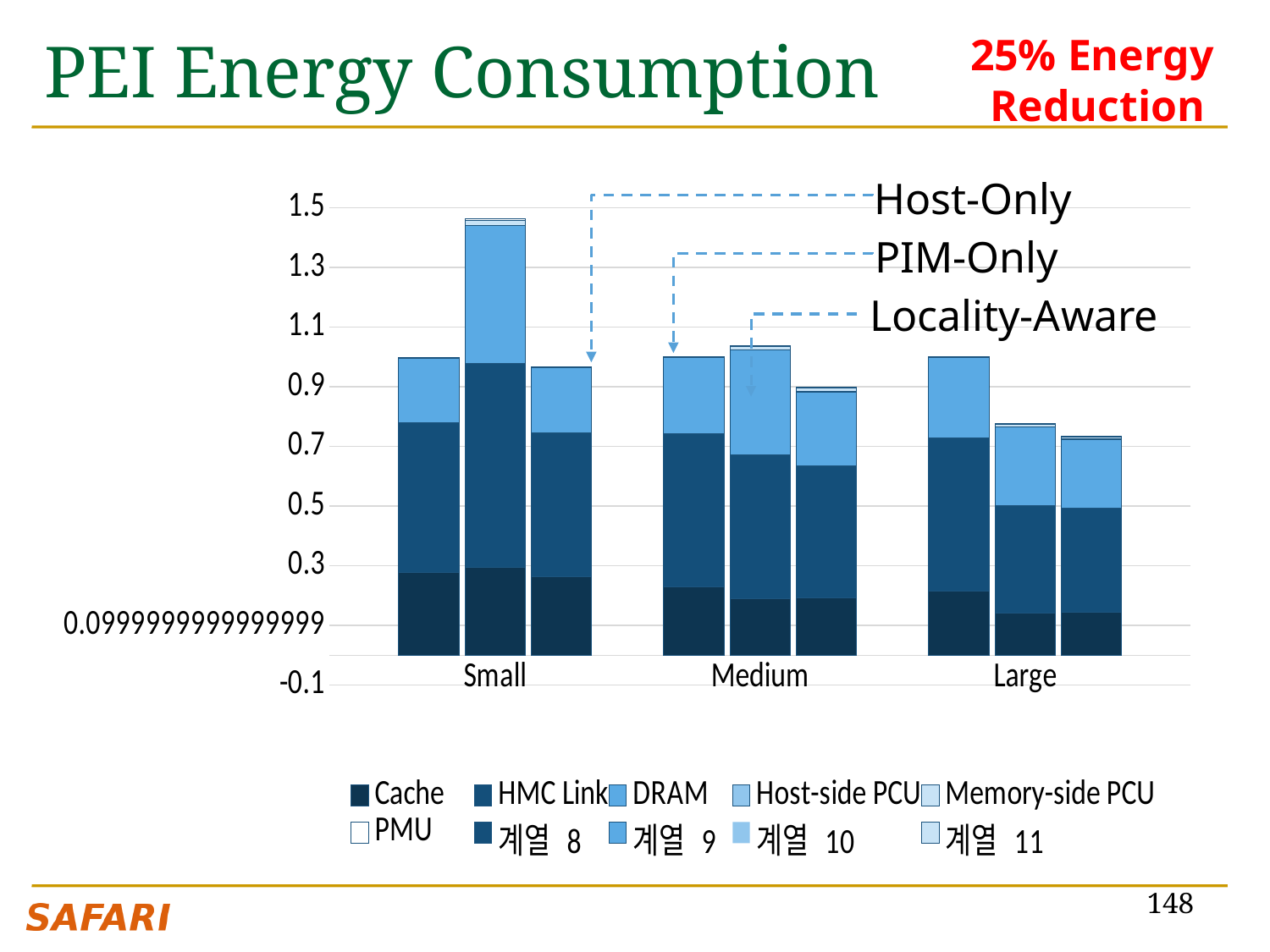
Which bar is the tallest in the chart? PIM-Only for Small How many workload size categories are shown on the x axis? 3 What kind of chart is shown on the slide? stacked bar chart Is the PIM-Only bar for Small greater or less than 1.3? greater How many entries does the legend list? 10 For Small, which bar is taller: PIM-Only or Locality-Aware? PIM-Only What is the title of the chart? PEI Energy Consumption For Medium, which bar is taller: PIM-Only or Locality-Aware? PIM-Only Is the Locality-Aware bar for Large greater or less than 0.9? less What energy reduction is highlighted in red at the top right of the slide? 25% Energy Reduction Do the Locality-Aware bars rise or fall from Small to Large? fall Is the PIM-Only bar for Large greater or less than 0.9? less